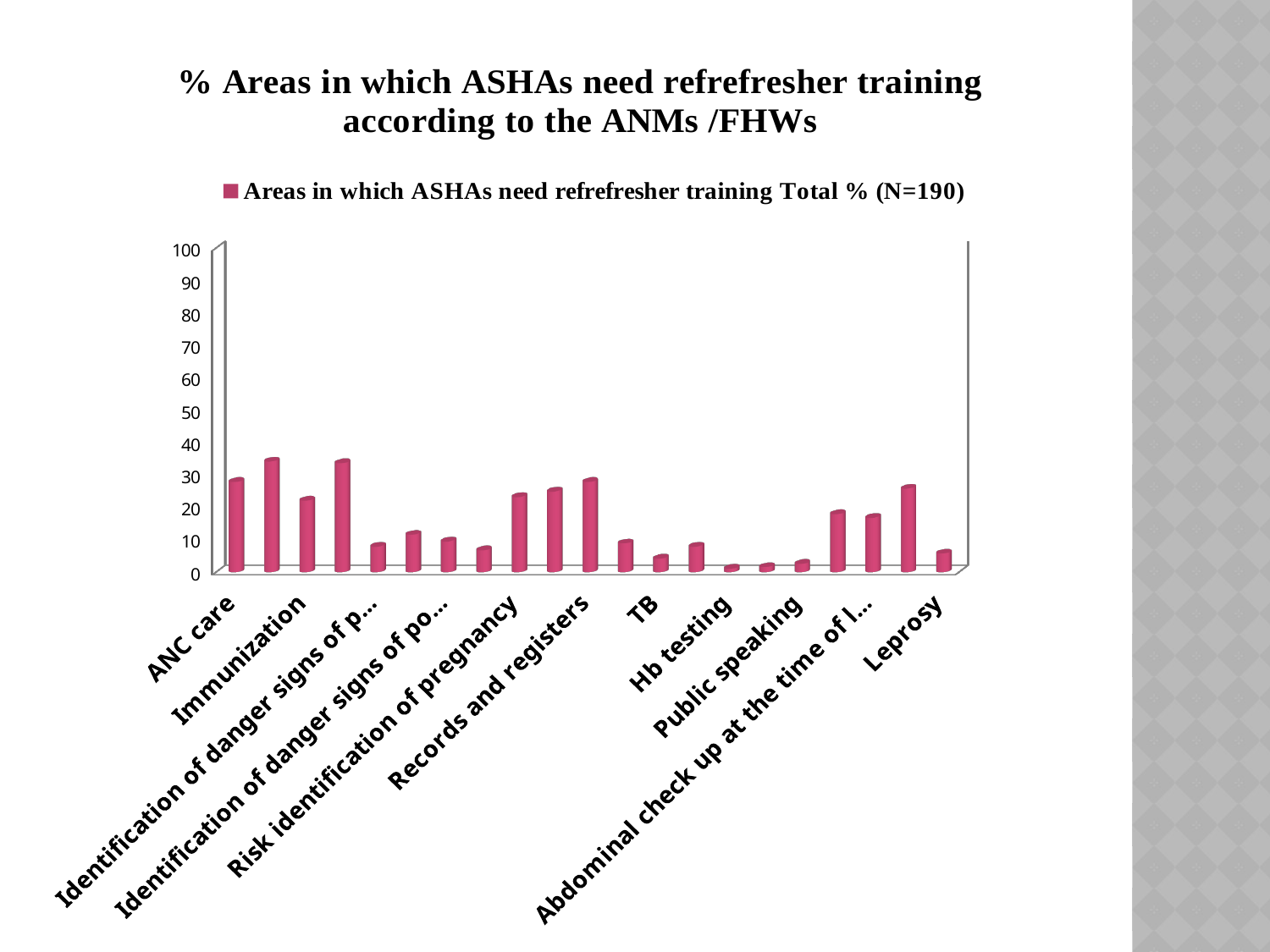
Is the value for TB greater or less than 10? less Which is larger, the value for Hb testing or the value for Leprosy? Leprosy How many series does the legend list? 1 Is the value for Leprosy greater or less than 10? less Is the value for Immunization greater or less than 30? less How many bars are plotted in the chart? 21 What kind of chart is shown on the slide? bar chart Which is larger, the value for ANC care or the value for TB? ANC care What is the legend entry for the plotted series? Areas in which ASHAs need refrefresher training Total % (N=190)